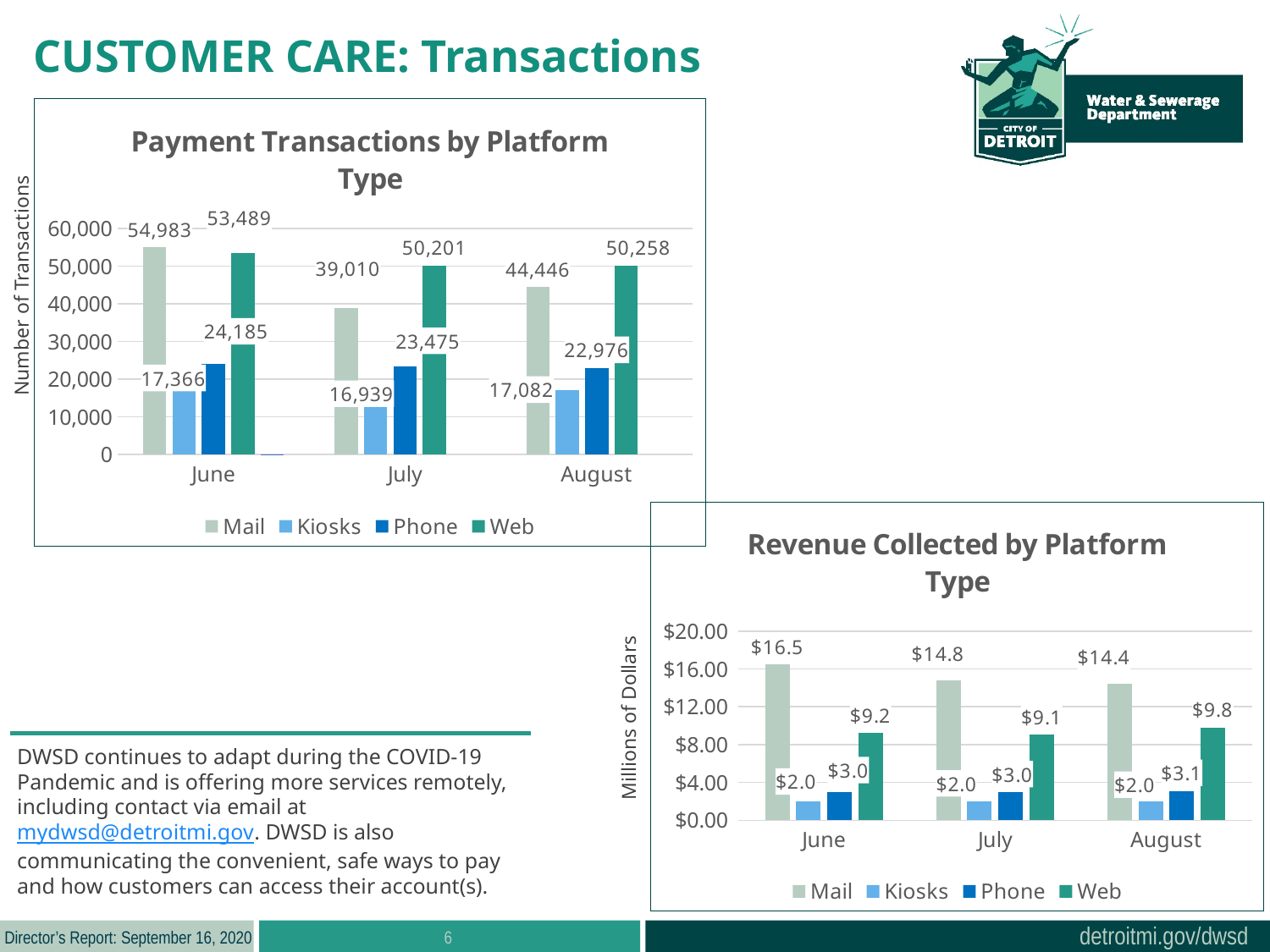
How many series does the legend of the Revenue Collected by Platform Type chart list? 4 In the Payment Transactions by Platform Type chart, how many Web transactions were there in August? 50,258 In the Payment Transactions by Platform Type chart, which had more transactions in June, Mail or Web? Mail In the Revenue Collected by Platform Type chart, what is the Web revenue for August? $9.8 In the Revenue Collected by Platform Type chart, what is the difference between Mail revenue and Web revenue in June? $7.3 In the Payment Transactions by Platform Type chart, how many Mail transactions were there in June? 54,983 In the Payment Transactions by Platform Type chart, what is the difference between Mail transactions in June and Mail transactions in July? 15,973 How many months are shown on the x axis of the Payment Transactions by Platform Type chart? 3 What kind of chart is the Revenue Collected by Platform Type chart? bar chart In the Revenue Collected by Platform Type chart, does Mail revenue rise or fall from June to August? fall In the Payment Transactions by Platform Type chart, is the value for Kiosks in July greater or less than 20,000? less In the Payment Transactions by Platform Type chart, which platform had the most transactions in July? Web